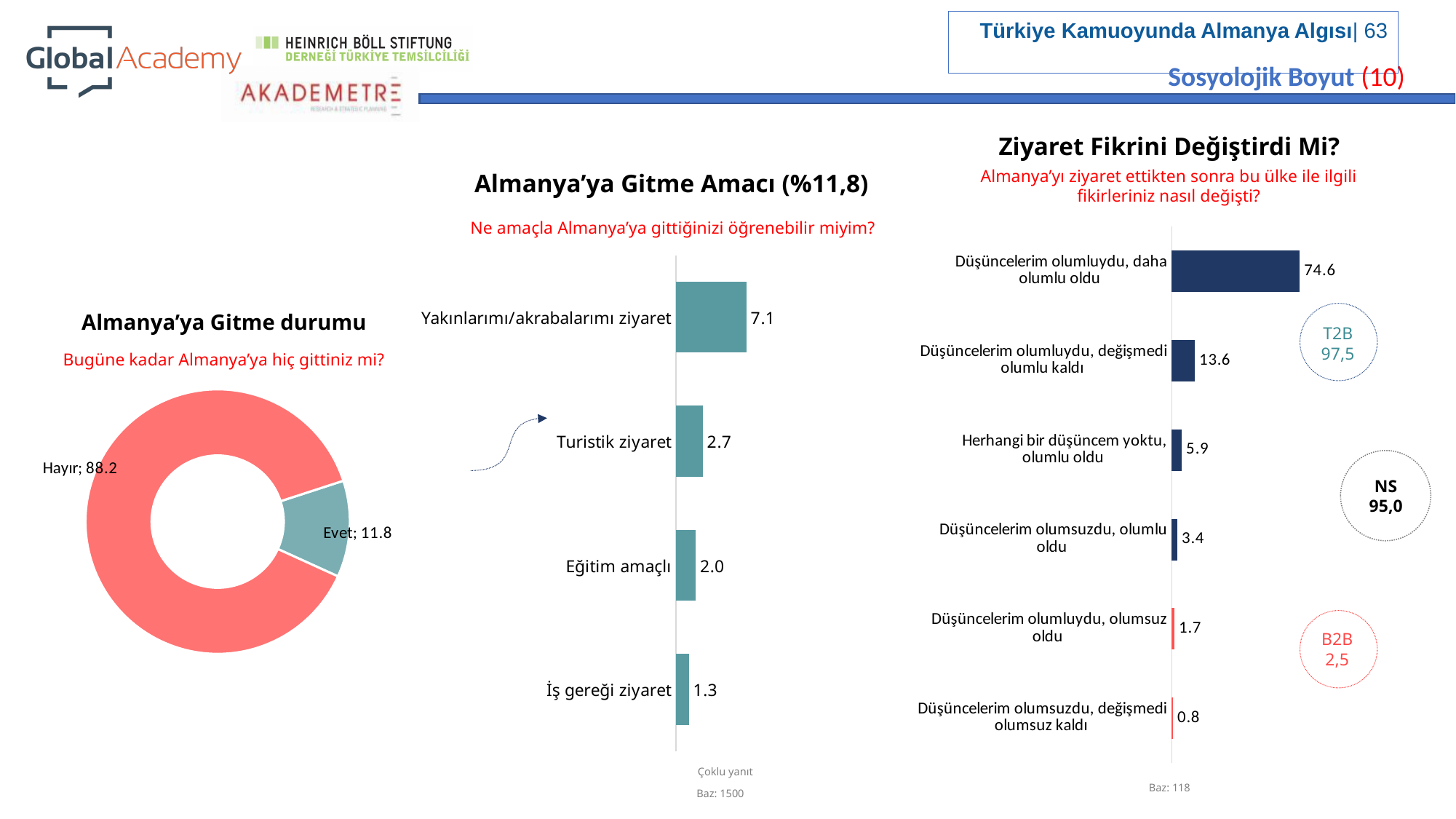
In the 'Ziyaret Fikrini Değiştirdi Mi?' chart, which is larger: 'Herhangi bir düşüncem yoktu, olumlu oldu' or 'Düşüncelerim olumsuzdu, olumlu oldu'? Herhangi bir düşüncem yoktu, olumlu oldu What kind of chart is 'Almanya'ya Gitme durumu'? Pie chart (donut) In the 'Almanya'ya Gitme Amacı' chart, what is the value for Turistik ziyaret? 2.7 In the 'Almanya'ya Gitme Amacı' chart, which category has the lowest value? İş gereği ziyaret In the 'Almanya'ya Gitme Amacı' chart, what is the difference between Yakınlarımı/akrabalarımı ziyaret and Eğitim amaçlı? 5.1 In the 'Almanya'ya Gitme durumu' chart, what is the value for Hayır? 88.2 In the 'Almanya'ya Gitme durumu' chart, what is the value for Evet? 11.8 In the 'Almanya'ya Gitme Amacı' chart, how many categories are shown? 4 In the 'Almanya'ya Gitme Amacı' chart, which category has the highest value? Yakınlarımı/akrabalarımı ziyaret In the 'Ziyaret Fikrini Değiştirdi Mi?' chart, what is the value for 'Düşüncelerim olumluydu, daha olumlu oldu'? 74.6 In the 'Ziyaret Fikrini Değiştirdi Mi?' chart, which category has the lowest value? Düşüncelerim olumsuzdu, değişmedi olumsuz kaldı In the 'Ziyaret Fikrini Değiştirdi Mi?' chart, how many categories are shown? 6